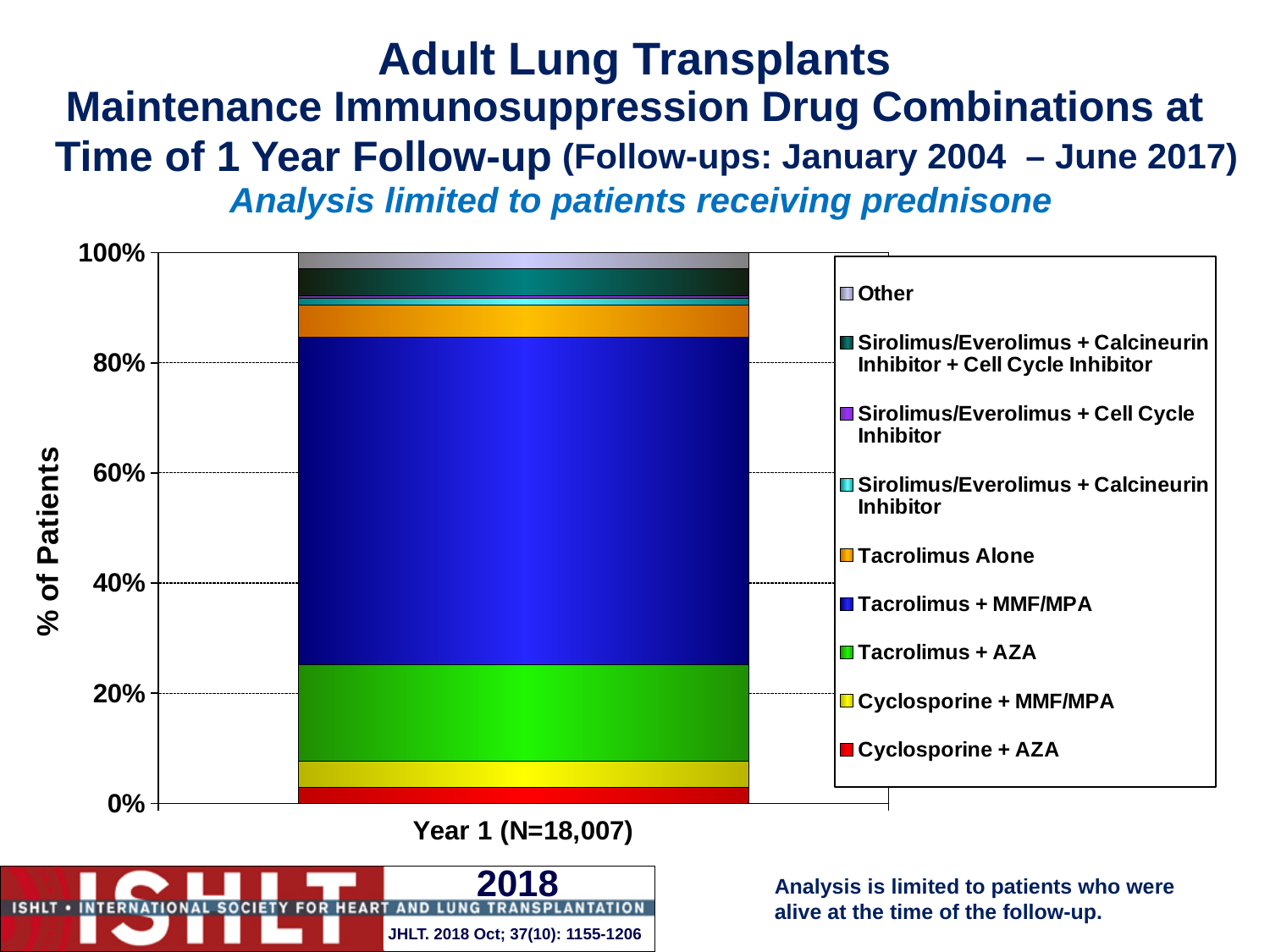
Which drug combination makes up the largest segment of the Year 1 bar? Tacrolimus + MMF/MPA Which segment is larger in the Year 1 bar: Tacrolimus + MMF/MPA or Tacrolimus + AZA? Tacrolimus + MMF/MPA Is the share of patients on Cyclosporine + AZA at Year 1 greater or less than 20%? less Is the share of patients on Tacrolimus Alone at Year 1 greater or less than 20%? less Is the share of patients on Tacrolimus + MMF/MPA at Year 1 greater or less than 40%? greater What kind of chart is shown on the slide? Stacked bar chart Which segment is larger in the Year 1 bar: Tacrolimus + AZA or Cyclosporine + MMF/MPA? Tacrolimus + AZA What is the label of the single category on the x axis? Year 1 (N=18,007) What is the label of the y axis? % of Patients How many drug combination series does the legend list? 9 How many bars (categories) are plotted on the x axis? 1